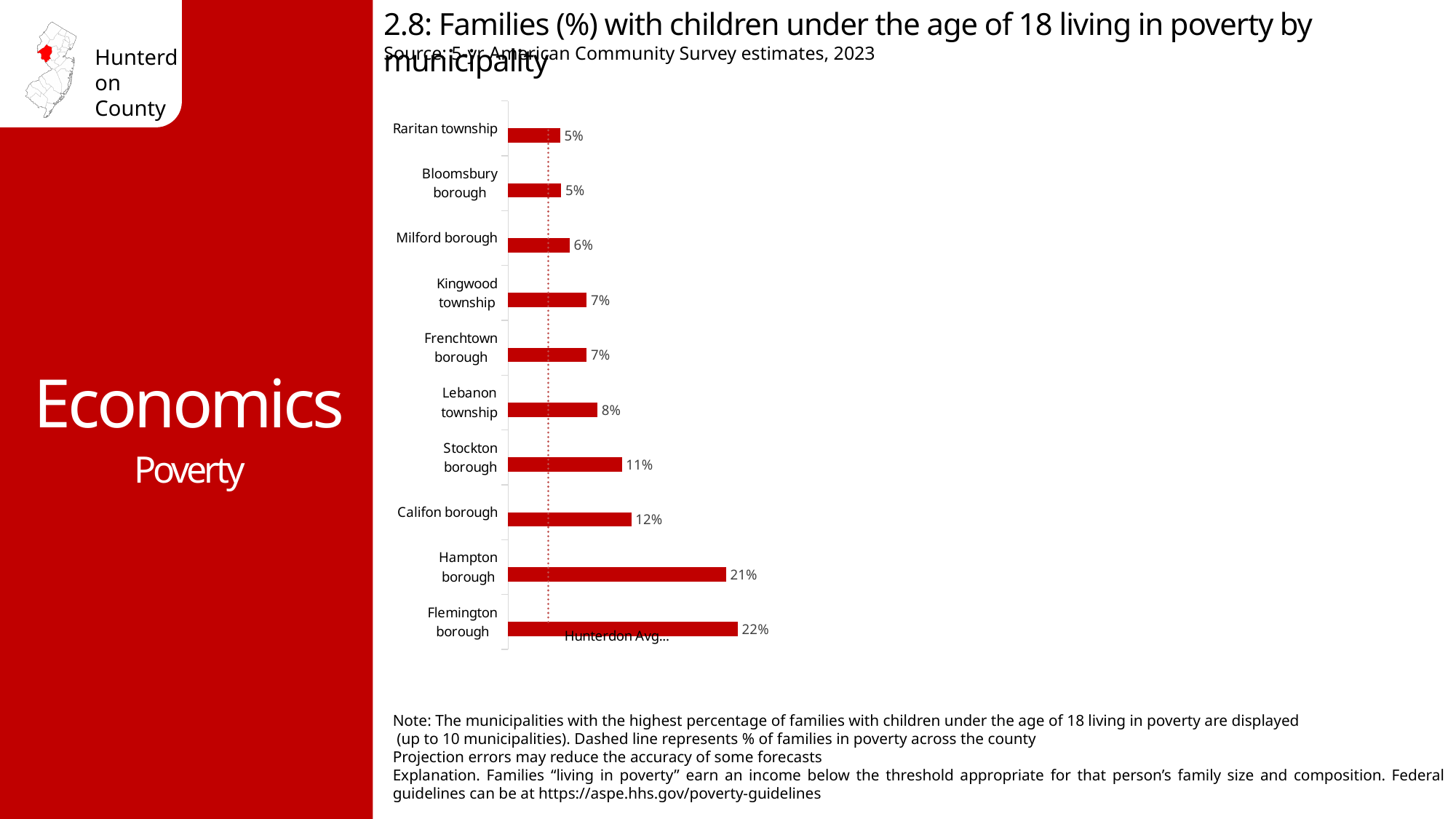
According to the note, what does the dashed line in the chart represent? % of families in poverty across the county What is the difference between the values for Califon borough and Raritan township? 7 percentage points Which municipality has the highest percentage of families with children under 18 living in poverty? Flemington borough How many municipalities are shown in the chart? 10 Which has a larger value, Hampton borough or Califon borough? Hampton borough What is the value for Stockton borough? 11% What is the value for Flemington borough? 22% What is the value for Milford borough? 6% What is the difference between the values for Flemington borough and Hampton borough? 1 percentage point What kind of chart is shown on the slide? Bar chart What is the value for Lebanon township? 8% What is the lowest value shown in the chart? 5%